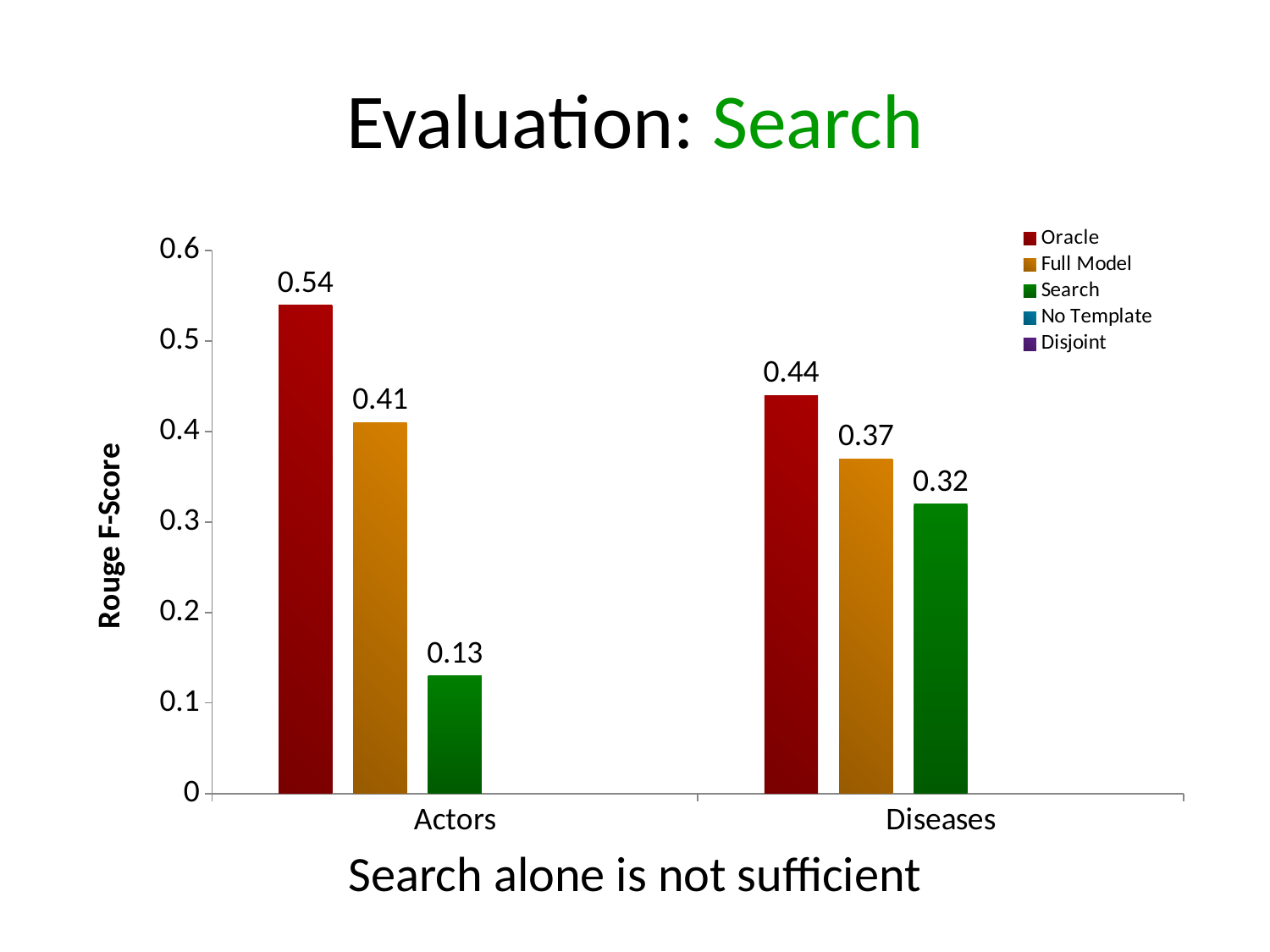
What is the difference between the Full Model and Search scores for Diseases? 0.05 Which series has the lowest Rouge F-Score for Actors? Search What is the Rouge F-Score for Full Model on Actors? 0.41 What is the Rouge F-Score for Oracle on Actors? 0.54 What kind of chart is shown on the slide? Bar chart Which series has the highest Rouge F-Score for Diseases? Oracle How many categories are shown on the x axis? 2 What is the Rouge F-Score for Search on Diseases? 0.32 What is the difference between the Oracle and Search scores for Actors? 0.41 What is the label of the y axis? Rouge F-Score Which is larger, the Search score for Actors or the Search score for Diseases? Diseases How many series does the legend list? 5